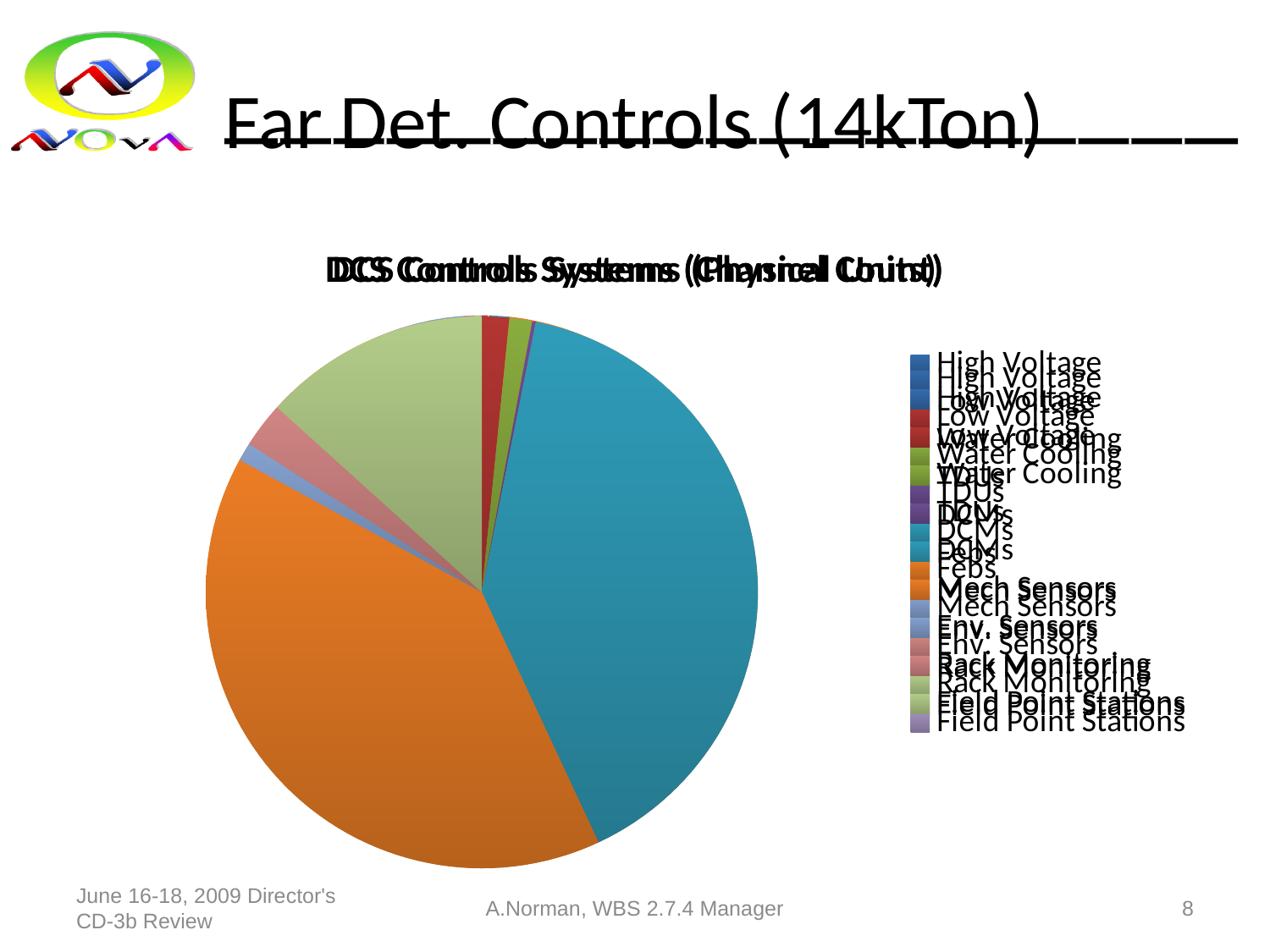
What kind of chart is shown on the slide? pie chart Which is larger in the pie chart, the teal slice or the red slice? the teal slice Does the pie chart display numeric data labels on its slices? No Which colour slice of the pie chart is the largest? teal How many distinct category names are listed in the pie chart's legend? 10 What is the title of the slide? Far Det. Controls (14kTon) Which is larger in the pie chart, the orange slice or the light green slice? the orange slice